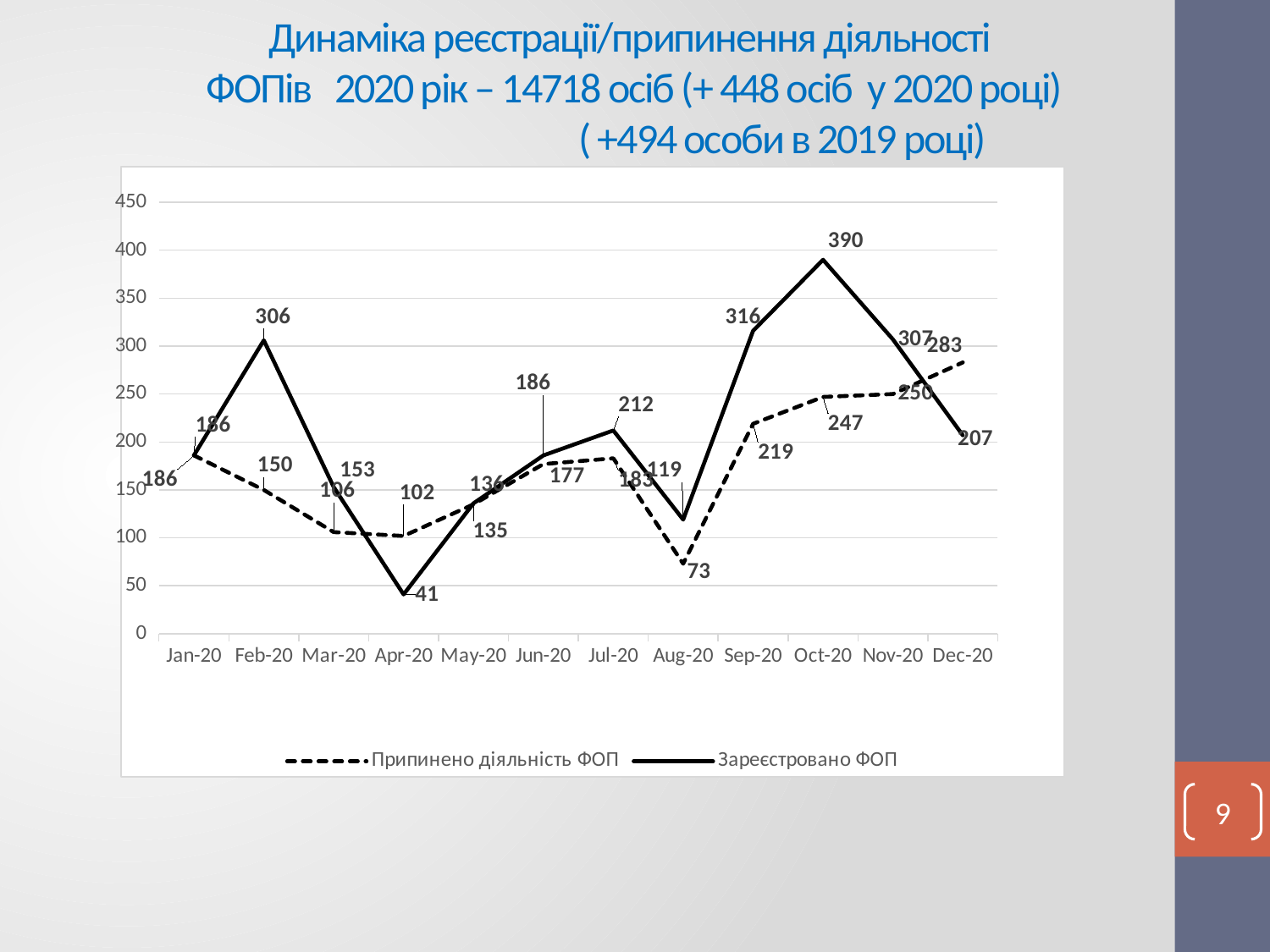
What is the value of Зареєстровано ФОП in Feb-20? 306 How many months are plotted along the x axis? 12 Which is larger in Dec-20: Зареєстровано ФОП or Припинено діяльність ФОП? Припинено діяльність ФОП What is the value of Зареєстровано ФОП in Oct-20? 390 In which month is Зареєстровано ФОП lowest? Apr-20 In which month is Припинено діяльність ФОП lowest? Aug-20 What is the value of Припинено діяльність ФОП in Aug-20? 73 In which month is Зареєстровано ФОП highest? Oct-20 Which series is drawn with a dashed line? Припинено діяльність ФОП What is the difference between Зареєстровано ФОП in Oct-20 (390) and Sep-20 (316)? 74 What type of chart is shown on the slide? line chart How many series does the legend list? 2